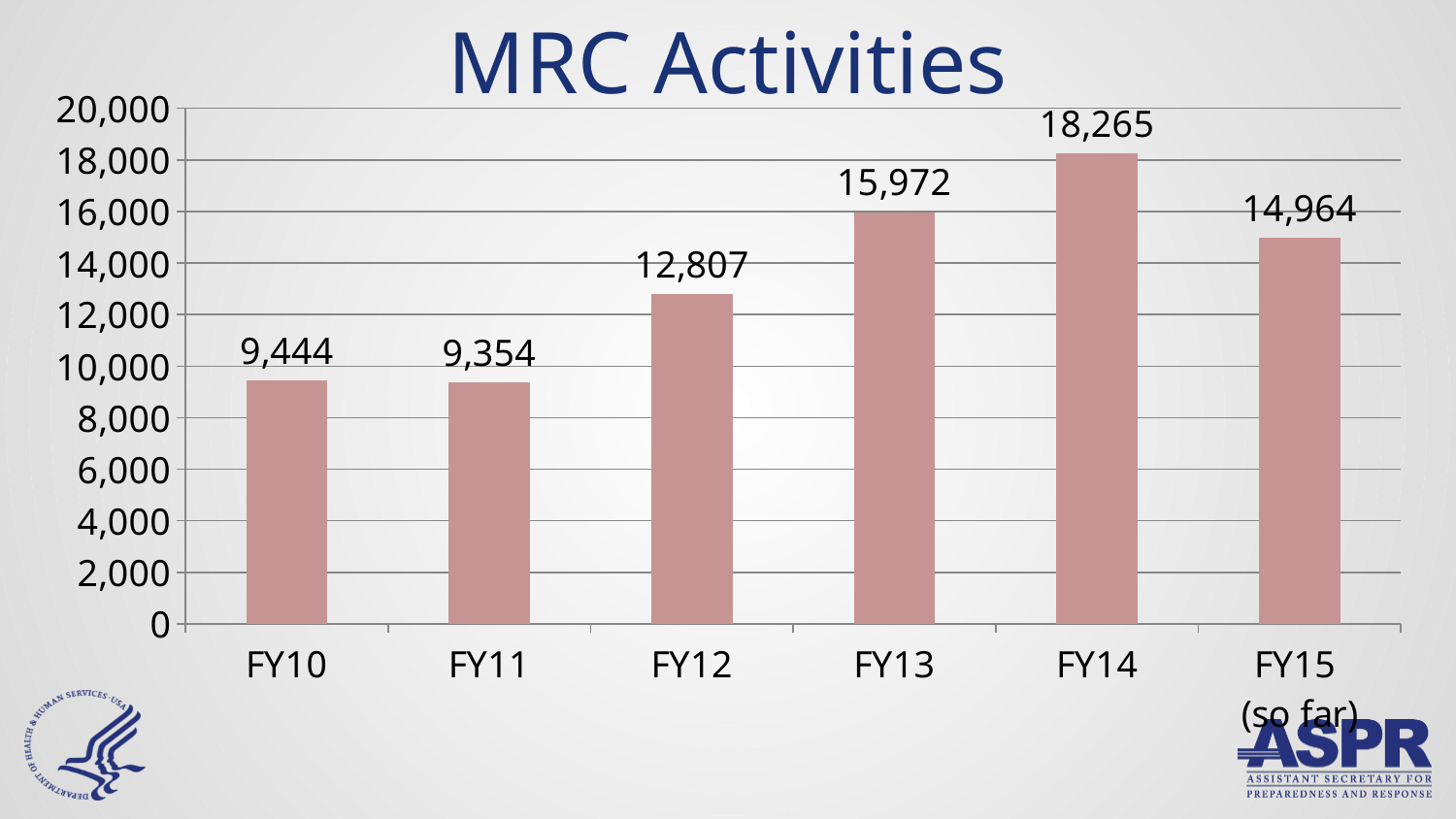
What is the title of the chart? MRC Activities Which fiscal year has the highest value? FY14 Which fiscal year has the lowest value? FY11 What is the difference between the FY14 and FY13 values? 2,293 How many fiscal years are shown on the chart? 6 What is the difference between the FY12 and FY11 values? 3,453 What kind of chart is shown on the slide? bar chart Which is larger, the value for FY12 or the value for FY15 (so far)? FY15 (so far) What is the value for FY15 (so far)? 14,964 Is the value for FY13 greater or less than 14,000? greater What is the value for FY13? 15,972 What is the value for FY10? 9,444